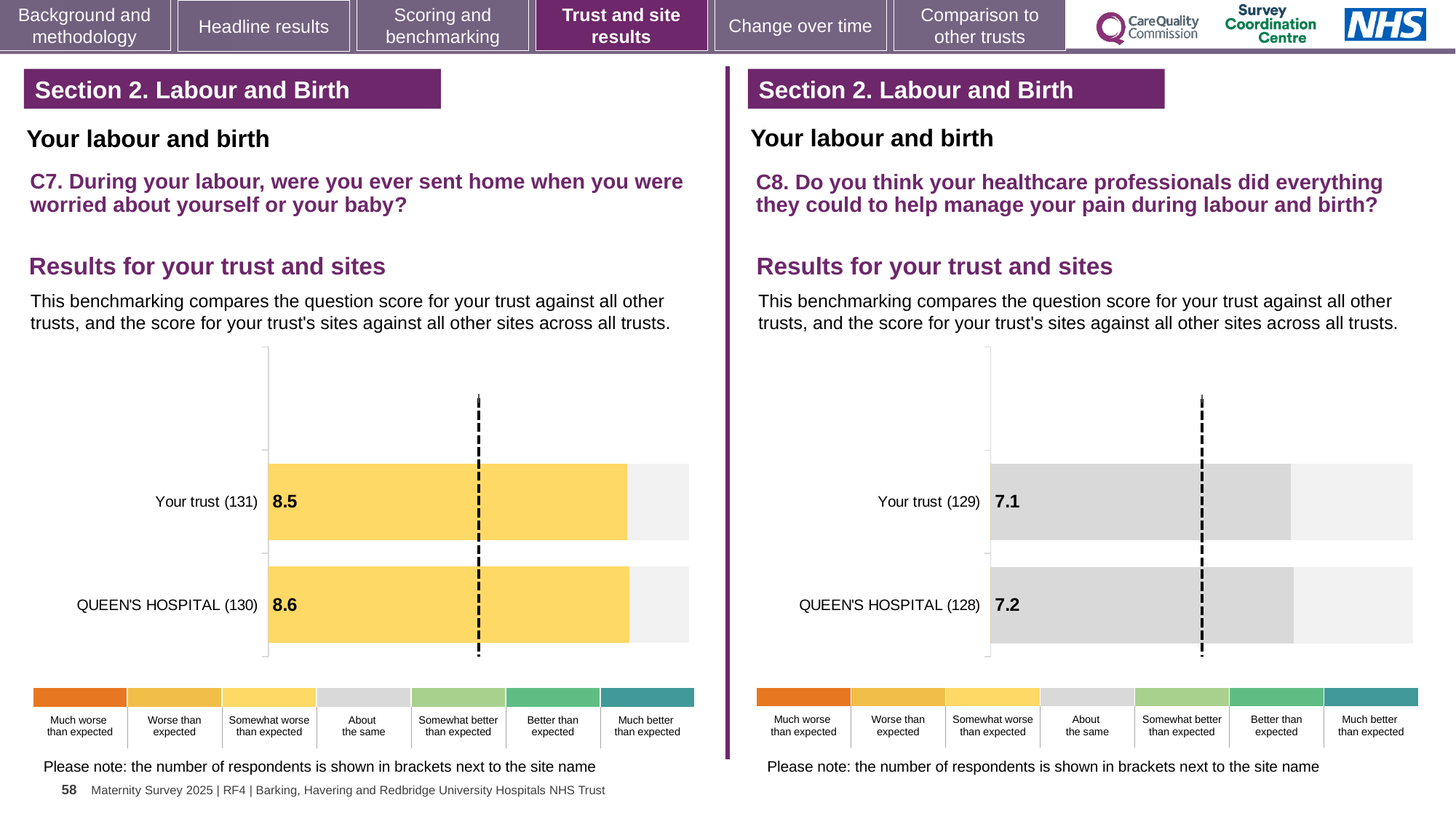
On the right chart (C8), how many respondents are shown in brackets for Your trust? 129 On the right chart (C8), what is the score for QUEEN'S HOSPITAL? 7.2 How many bars are plotted on the left chart (C7)? 2 On the left chart (C7), what is the score for Your trust? 8.5 On the right chart (C8), what is the score for Your trust? 7.1 Which benchmark category does the colour of the bars on the right chart (C8) correspond to in the legend? About the same Which benchmark category does the colour of the bars on the left chart (C7) correspond to in the legend? Somewhat worse than expected On the right chart (C8), what is the difference between the QUEEN'S HOSPITAL score and the Your trust score? 0.1 What kind of chart is used on the right side of the slide (C8)? Bar chart On the left chart (C7), how many respondents are shown in brackets for QUEEN'S HOSPITAL? 130 On the left chart (C7), what is the difference between the QUEEN'S HOSPITAL score and the Your trust score? 0.1 On the left chart (C7), what is the score for QUEEN'S HOSPITAL? 8.6